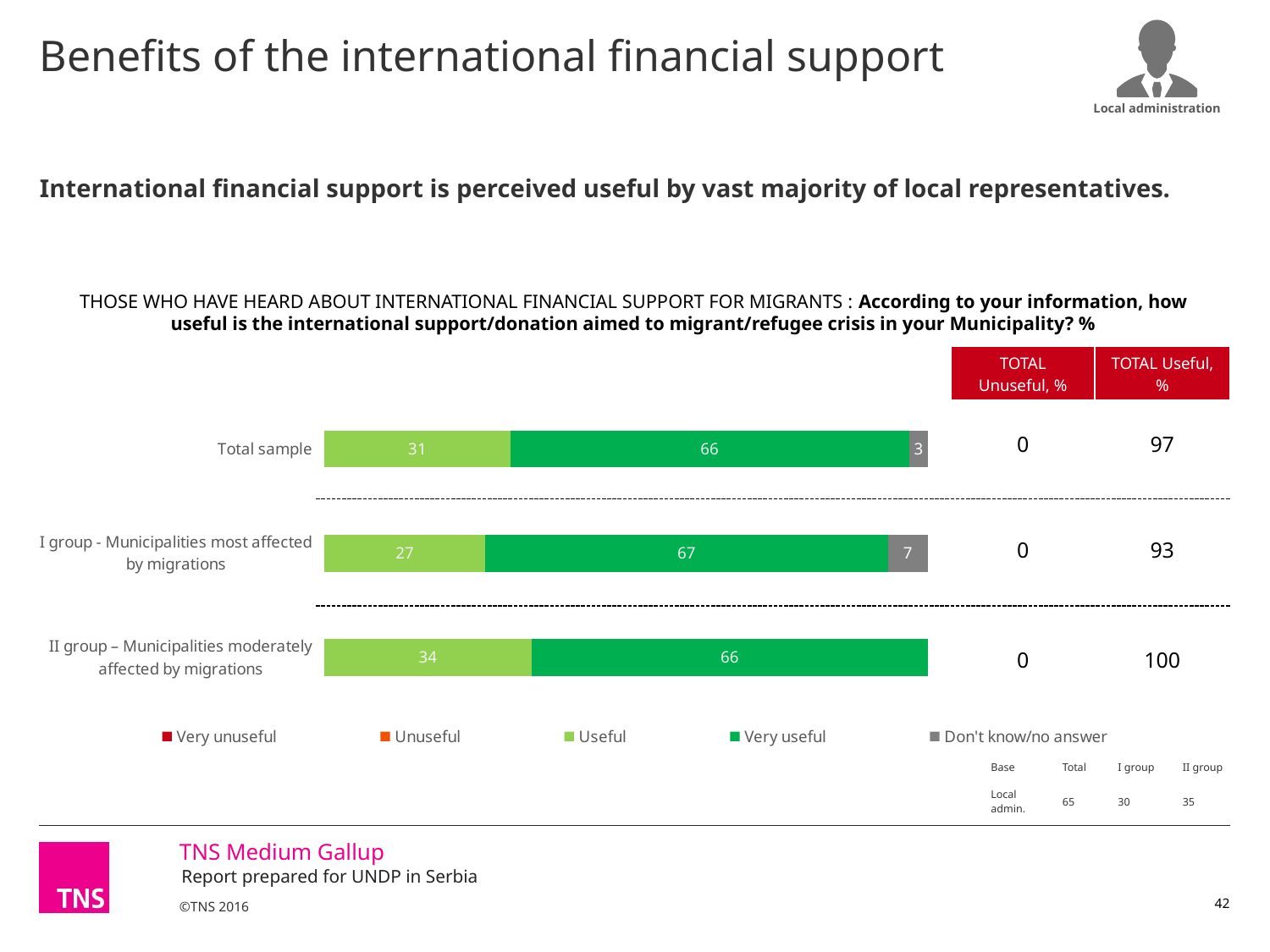
How many series does the legend list? 5 Is the 'Very useful' value larger for I group or for the Total sample? I group What is the 'Very useful' value for the Total sample? 66 What is the TOTAL Useful, % value for I group - Municipalities most affected by migrations? 93 What is the difference between the 'Useful' values for II group and I group? 7 Which group has the lowest 'Useful' value? I group - Municipalities most affected by migrations What is the 'Useful' value for I group - Municipalities most affected by migrations? 27 How many groups (bars) are shown in the chart? 3 What is the 'Useful' value for II group – Municipalities moderately affected by migrations? 34 Which group has the highest 'Useful' value? II group – Municipalities moderately affected by migrations What kind of chart is shown on the slide? Stacked bar chart What is the 'Don't know/no answer' value for I group - Municipalities most affected by migrations? 7